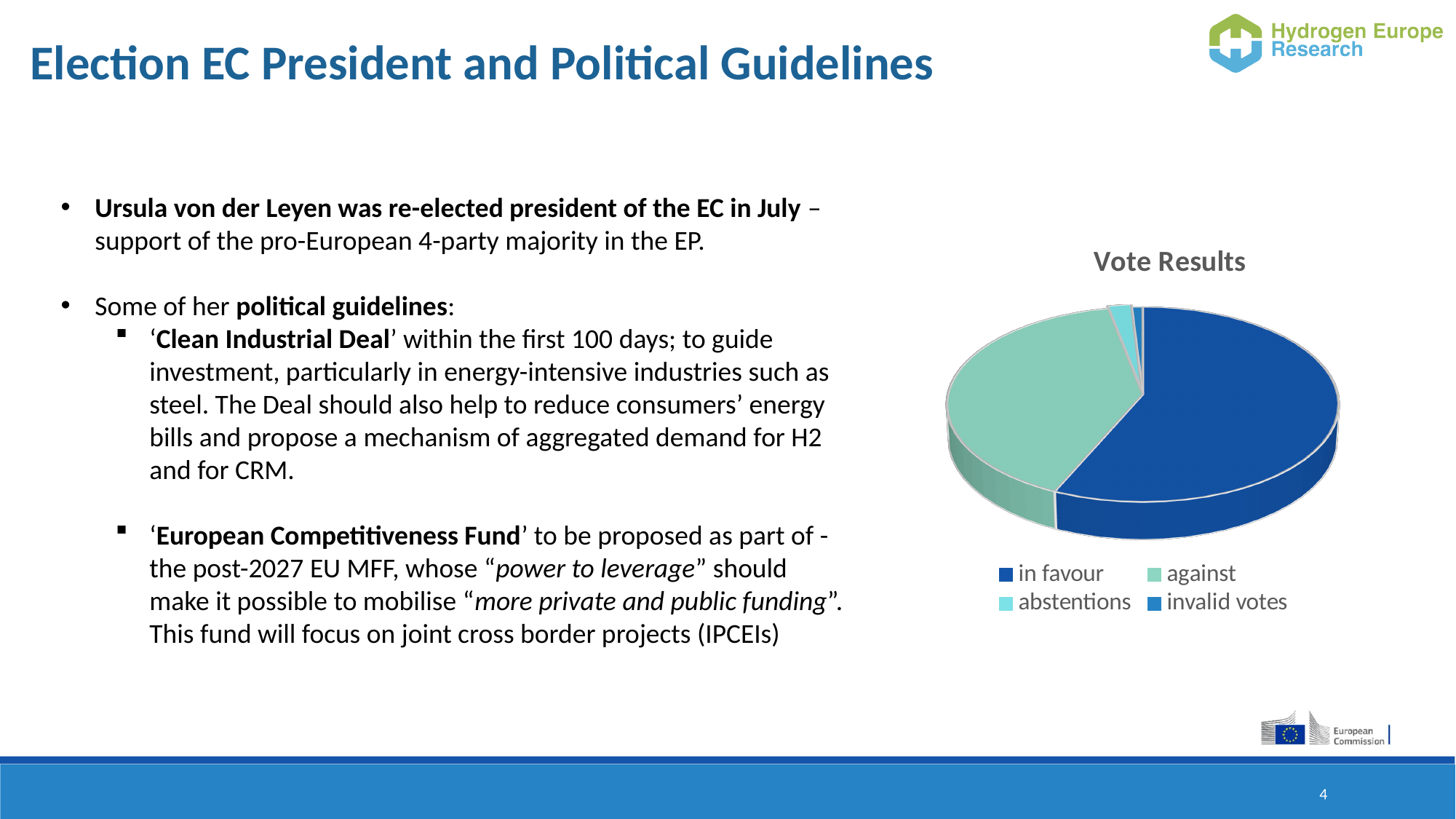
Which category has the largest slice in the Vote Results chart? in favour Which category has the smallest slice in the Vote Results chart? invalid votes How many categories does the legend of the Vote Results chart list? 4 Which category is shown in dark blue in the Vote Results chart? in favour What kind of chart is shown on the slide? pie chart In the Vote Results chart, which is larger: against or abstentions? against In the Vote Results chart, which is larger: abstentions or invalid votes? abstentions What is the title of the chart on the slide? Vote Results In the Vote Results chart, which is larger: in favour or against? in favour